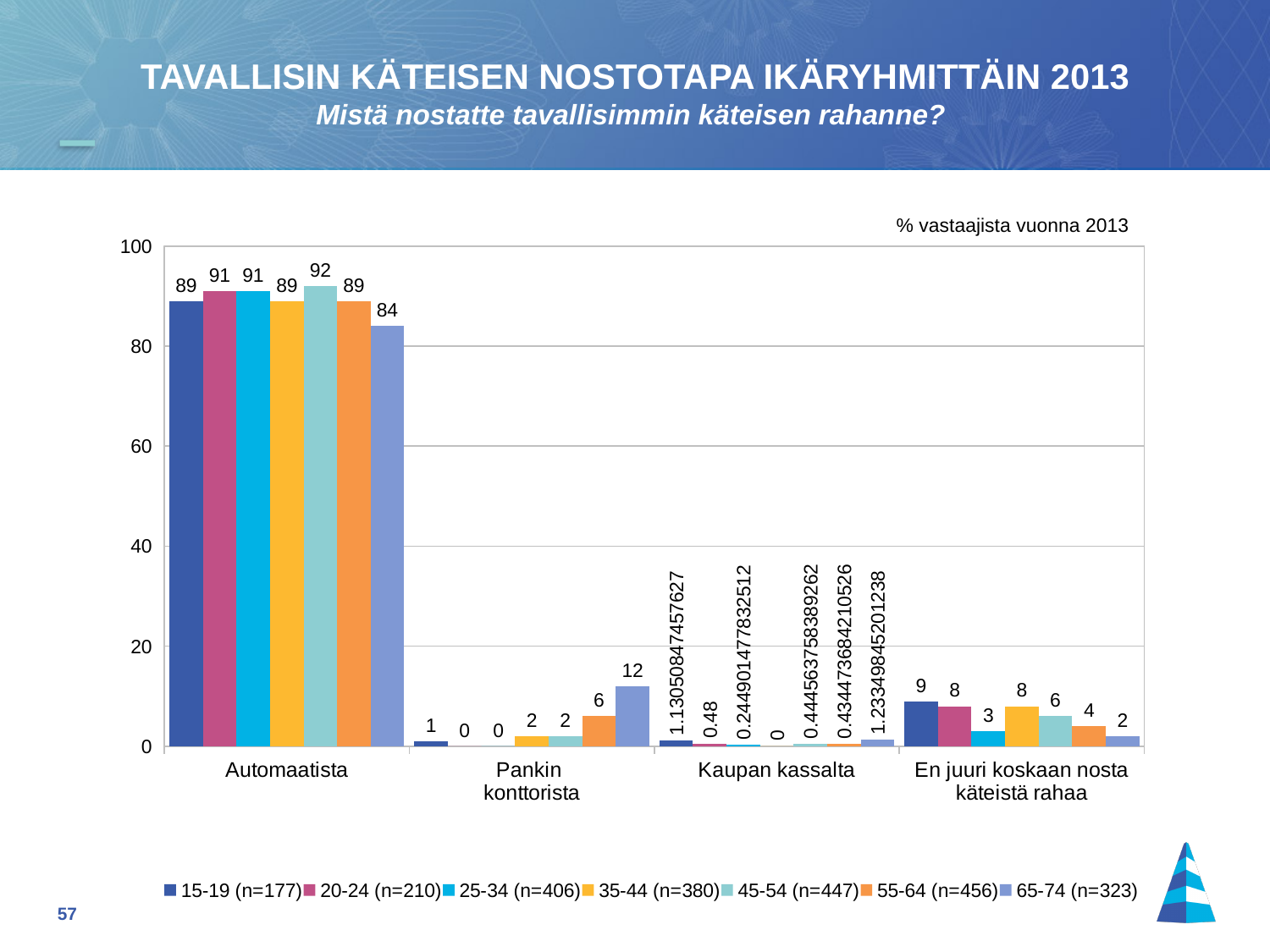
What is the value for the 15-19 age group in the 'En juuri koskaan nosta käteistä rahaa' category? 9 What is the value for the 65-74 age group in the Automaatista category? 84 What is the value for the 45-54 age group in the Automaatista category? 92 Which age group has the lowest value in the Automaatista category? 65-74 (n=323) What is the value for the 55-64 age group in the Pankin konttorista category? 6 What kind of chart is shown on the slide? Bar chart Which age group has the highest value in the Automaatista category? 45-54 (n=447) In the 'En juuri koskaan nosta käteistä rahaa' category, which is larger: the value for 15-19 or for 65-74? 15-19 What is the difference between the 45-54 and 65-74 values in the Automaatista category? 8 What is the value for the 65-74 age group in the Pankin konttorista category? 12 How many series does the legend list? 7 How many categories are shown on the x axis? 4